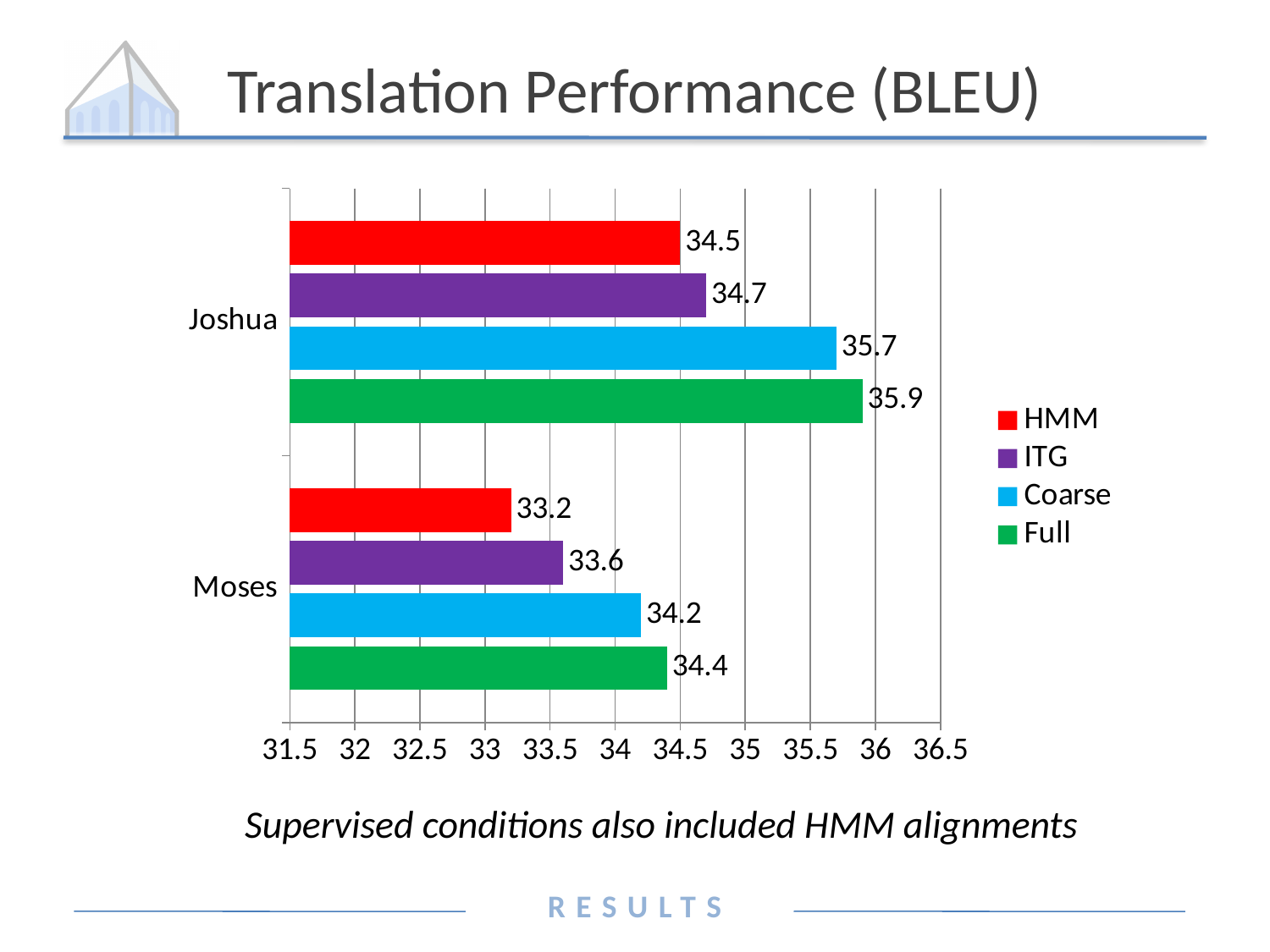
What is the BLEU score for the HMM series on Moses? 33.2 How many series does the legend list? 4 What is the BLEU score for the Coarse series on Joshua? 35.7 Which series has the highest BLEU score for Moses? Full What is the BLEU score for the Full series on Joshua? 35.9 What is the difference between the Full and HMM BLEU scores for Joshua? 1.4 What kind of chart is shown on the slide? Bar chart What colour represents the Coarse series in the chart? Blue What is the BLEU score for the ITG series on Moses? 33.6 Which is larger: the ITG score for Joshua or the Full score for Moses? ITG score for Joshua Which series has the lowest BLEU score for Joshua? HMM What is the difference between the Coarse and ITG BLEU scores for Moses? 0.6